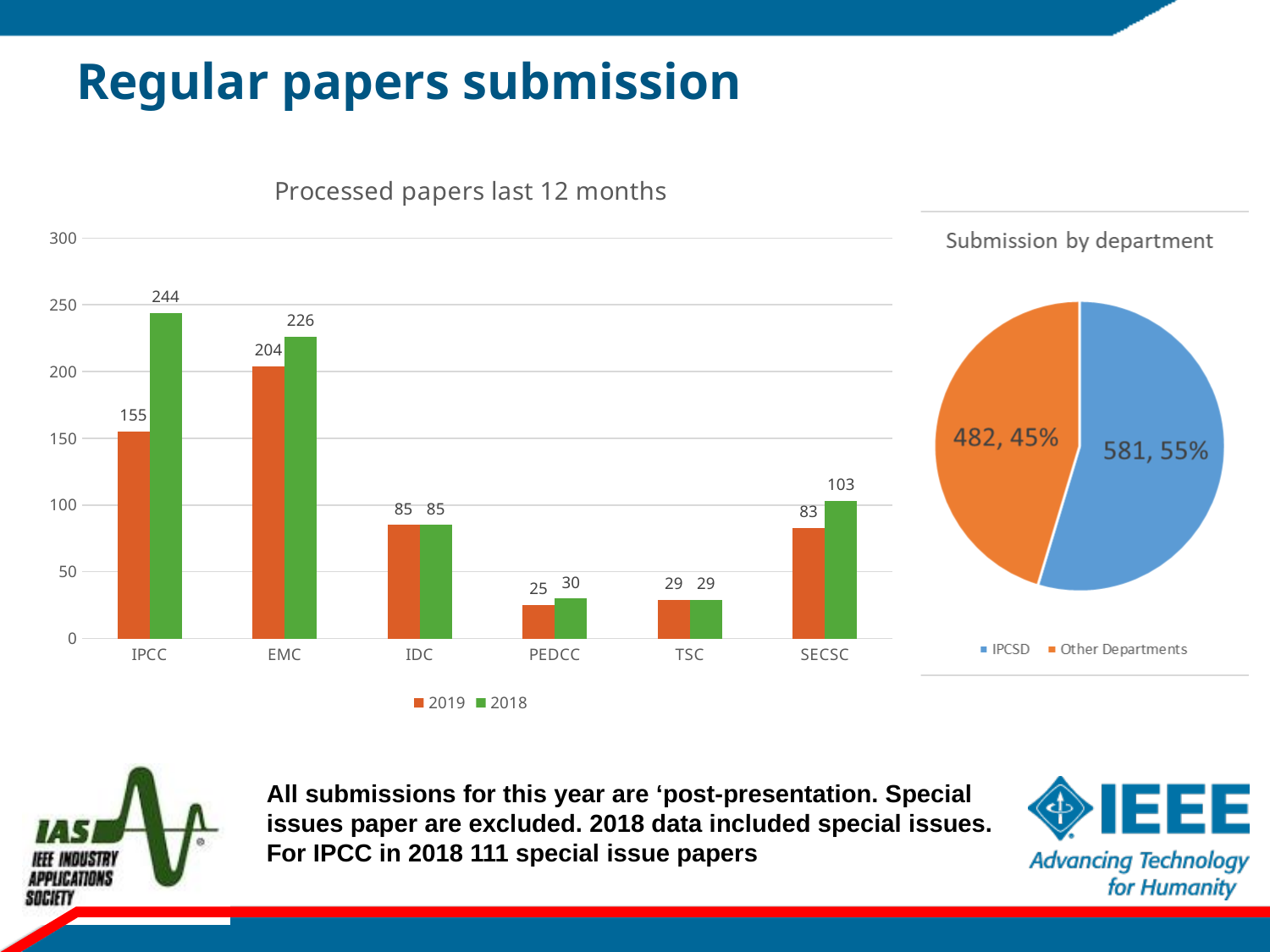
In the 'Submission by department' pie chart, what is the value shown for IPCSD? 581 What kind of chart is 'Processed papers last 12 months'? bar chart In the 'Processed papers last 12 months' chart, what is the 2018 value for IPCC? 244 How many categories are shown on the x axis of the 'Processed papers last 12 months' chart? 6 In the 'Processed papers last 12 months' chart, which category has the highest 2019 value? EMC In the 'Processed papers last 12 months' chart, what is the 2019 value for EMC? 204 How many series does the legend of the 'Processed papers last 12 months' chart list? 2 In the 'Processed papers last 12 months' chart, is the 2019 value for SECSC larger or smaller than the 2018 value for SECSC? smaller In the 'Processed papers last 12 months' chart, what is the difference between the 2018 and 2019 values for IPCC? 89 In the 'Processed papers last 12 months' chart, which category has the lowest 2018 value? TSC What kind of chart is 'Submission by department'? pie chart In the 'Submission by department' pie chart, what share of the pie is Other Departments? 45%